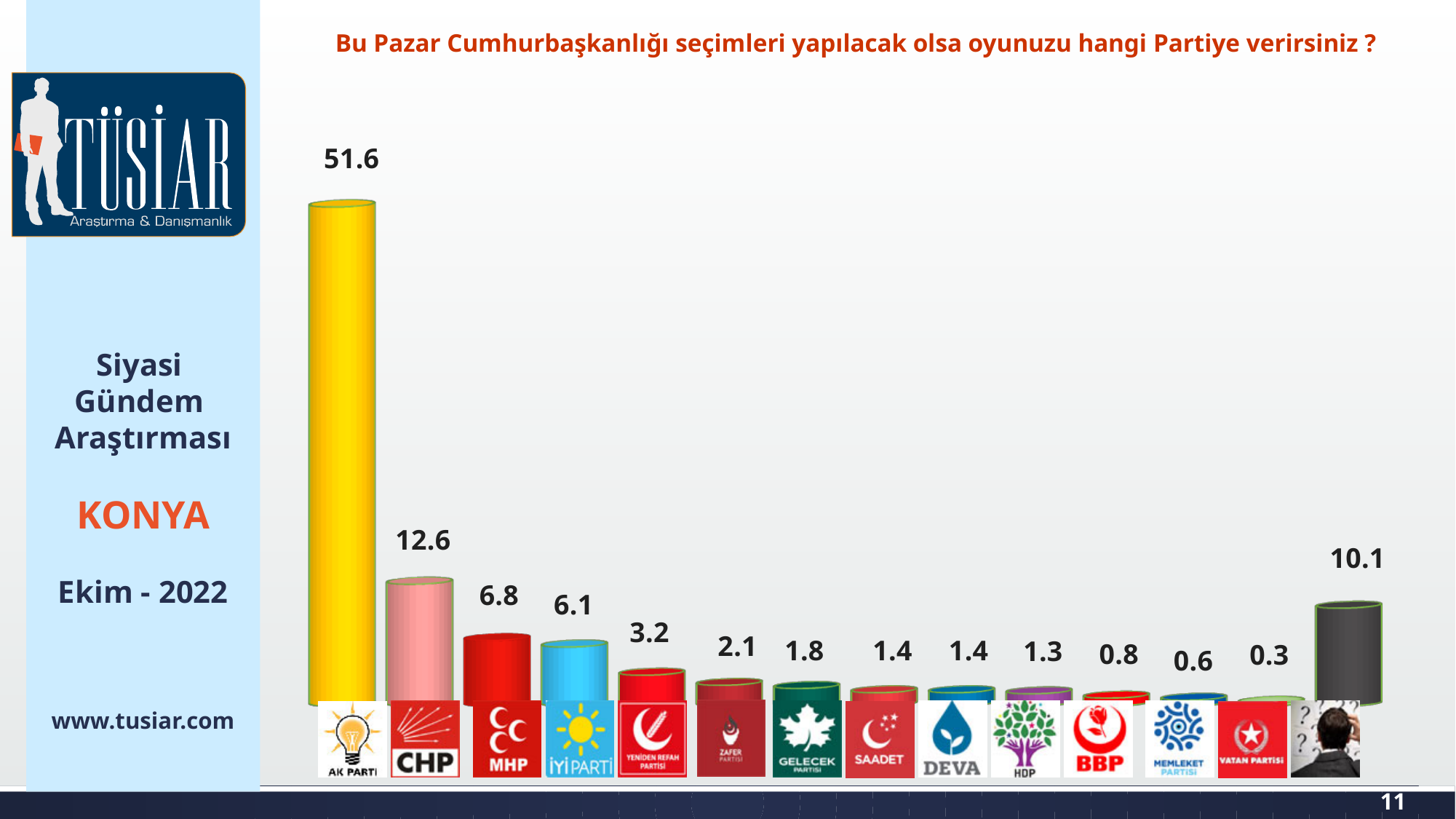
What is the value shown for AK Parti? 51.6 What is the title of the chart? Bu Pazar Cumhurbaşkanlığı seçimleri yapılacak olsa oyunuzu hangi Partiye verirsiniz ? What is the difference between the values for MHP and İYİ Parti? 0.7 Which party has the highest value in the chart? AK Parti How many bars are shown in the chart? 14 What is the difference between the values for AK Parti and CHP? 39.0 What is the value shown for the last bar on the right, labelled with the question-mark image? 10.1 Which has a larger value, Yeniden Refah Partisi or Zafer Partisi? Yeniden Refah Partisi What kind of chart is shown on the slide? Bar chart What is the value shown for CHP? 12.6 Which party has the lowest value in the chart? Vatan Partisi What is the value shown for İYİ Parti? 6.1